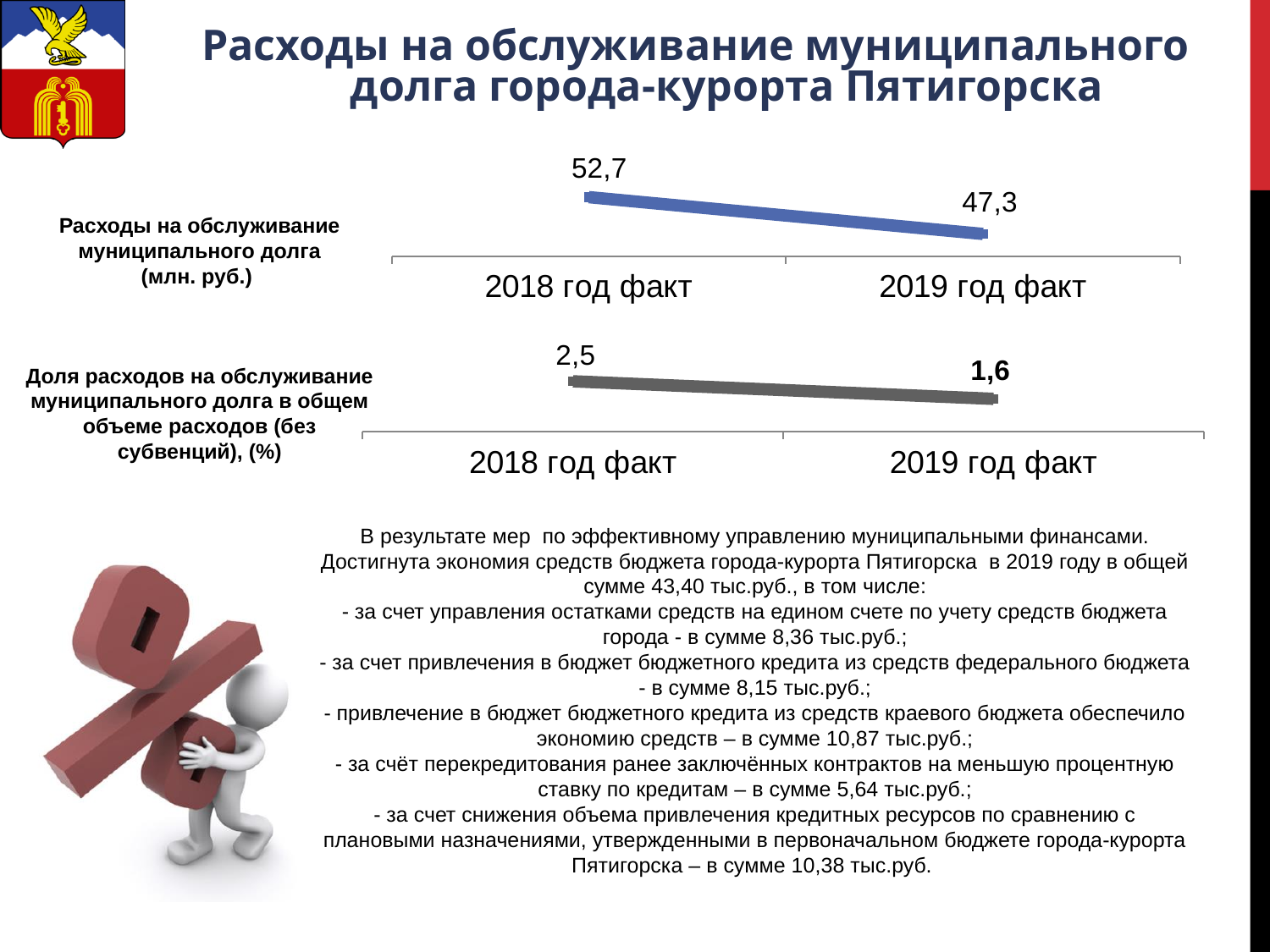
In the bottom chart (Доля расходов на обслуживание муниципального долга, %), what is the value for 2019 год факт? 1,6 In the bottom chart, do the values rise or fall from 2018 to 2019? fall What type of chart is used for the top chart on the slide? line chart In the bottom chart, which point is the lowest? 2019 год факт In the top chart (Расходы на обслуживание муниципального долга, млн. руб.), what is the value for 2018 год факт? 52,7 In the top chart, by how much did debt servicing expenses decrease from 2018 год факт to 2019 год факт? 5,4 In the bottom chart, what is the difference between the 2018 год факт and 2019 год факт values? 0,9 In the top chart (Расходы на обслуживание муниципального долга, млн. руб.), what is the value for 2019 год факт? 47,3 In the top chart, which year has the higher value, 2018 год факт or 2019 год факт? 2018 год факт In the bottom chart (Доля расходов на обслуживание муниципального долга, %), what is the value for 2018 год факт? 2,5 In the top chart, do the values rise or fall from 2018 to 2019? fall How many data points are plotted in the top chart? 2